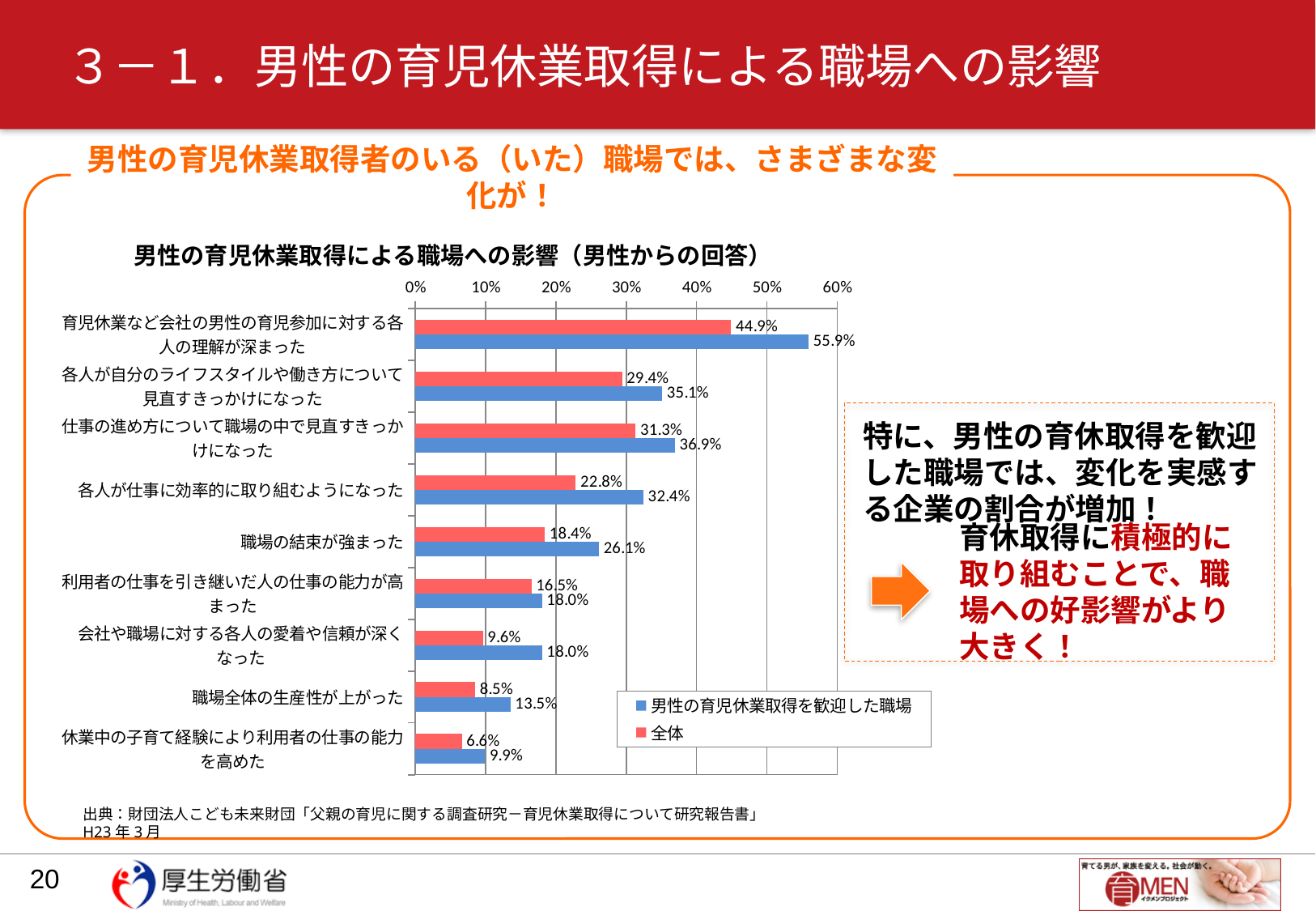
Which category has the lowest value for 全体? 休業中の子育て経験により利用者の仕事の能力を高めた For 会社や職場に対する各人の愛着や信頼が深くなった, which series has the larger value: 男性の育児休業取得を歓迎した職場 or 全体? 男性の育児休業取得を歓迎した職場 What is the title of the chart? 男性の育児休業取得による職場への影響（男性からの回答） How many series does the legend list? 2 Which category has the highest value for 男性の育児休業取得を歓迎した職場? 育児休業など会社の男性の育児参加に対する各人の理解が深まった What is the difference between the 男性の育児休業取得を歓迎した職場 value and the 全体 value for 育児休業など会社の男性の育児参加に対する各人の理解が深まった? 11.0% What kind of chart is shown on the slide? bar chart What is the value for 男性の育児休業取得を歓迎した職場 in the category 各人が仕事に効率的に取り組むようになった? 32.4% How many categories are shown in the chart? 9 Which colour represents the 全体 series in the chart? red Is the 全体 value for 仕事の進め方について職場の中で見直すきっかけになった greater or less than 30%? greater What is the value for 全体 in the category 職場の結束が強まった? 18.4%